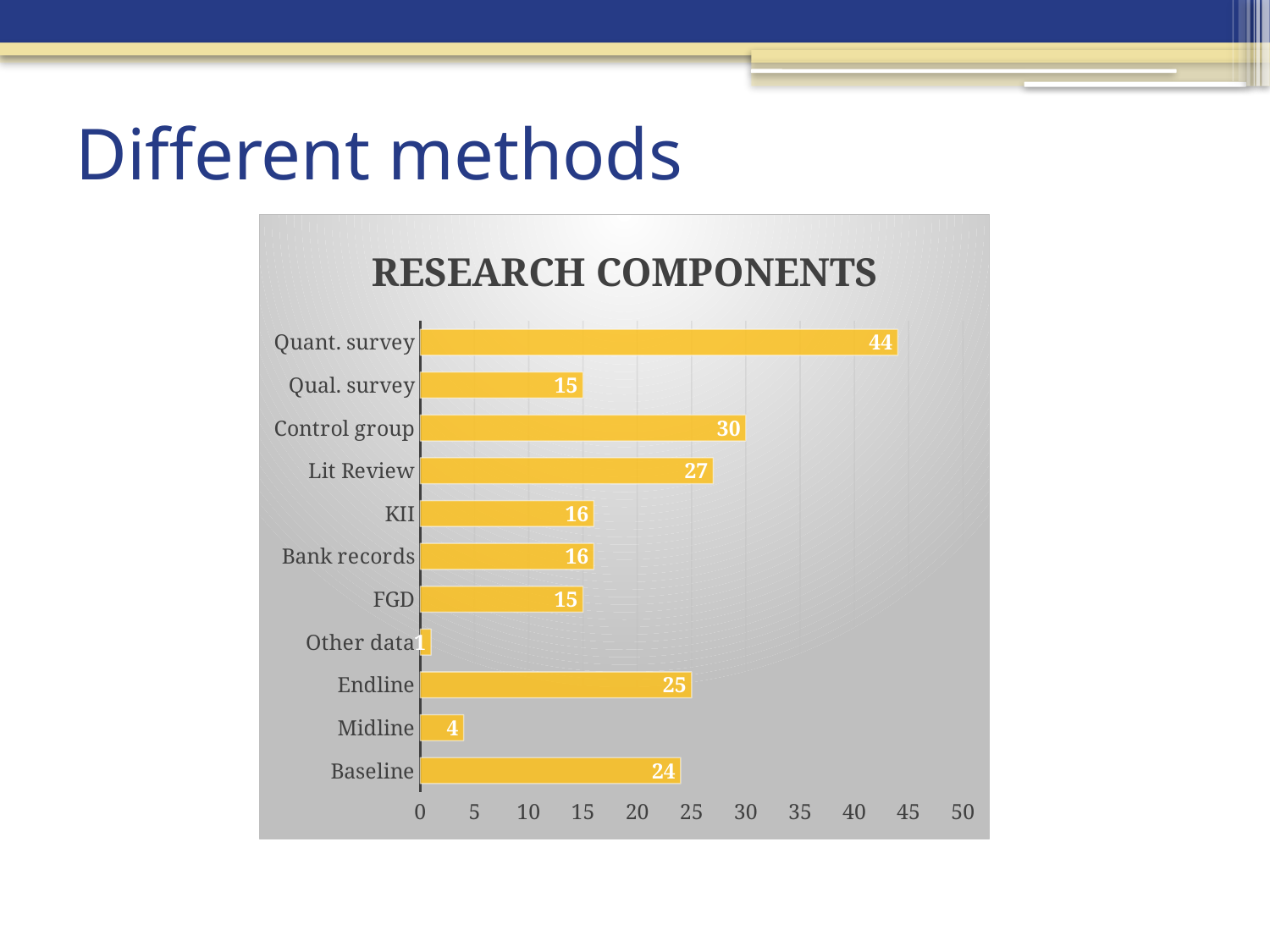
What is the value for Control group? 30 Is the value for Baseline greater or less than 20? greater How many research components are shown in the chart? 11 What is the difference between the values for Endline and Baseline? 1 Which is larger, the value for Lit Review or the value for Endline? Lit Review What is the difference between the values for Quant. survey and Control group? 14 What is the title of the chart? RESEARCH COMPONENTS What is the value for Quant. survey in the Research Components chart? 44 Which research component has the highest value? Quant. survey Which research component has the lowest value? Other data What is the value for Midline? 4 What kind of chart is shown on the slide? Bar chart